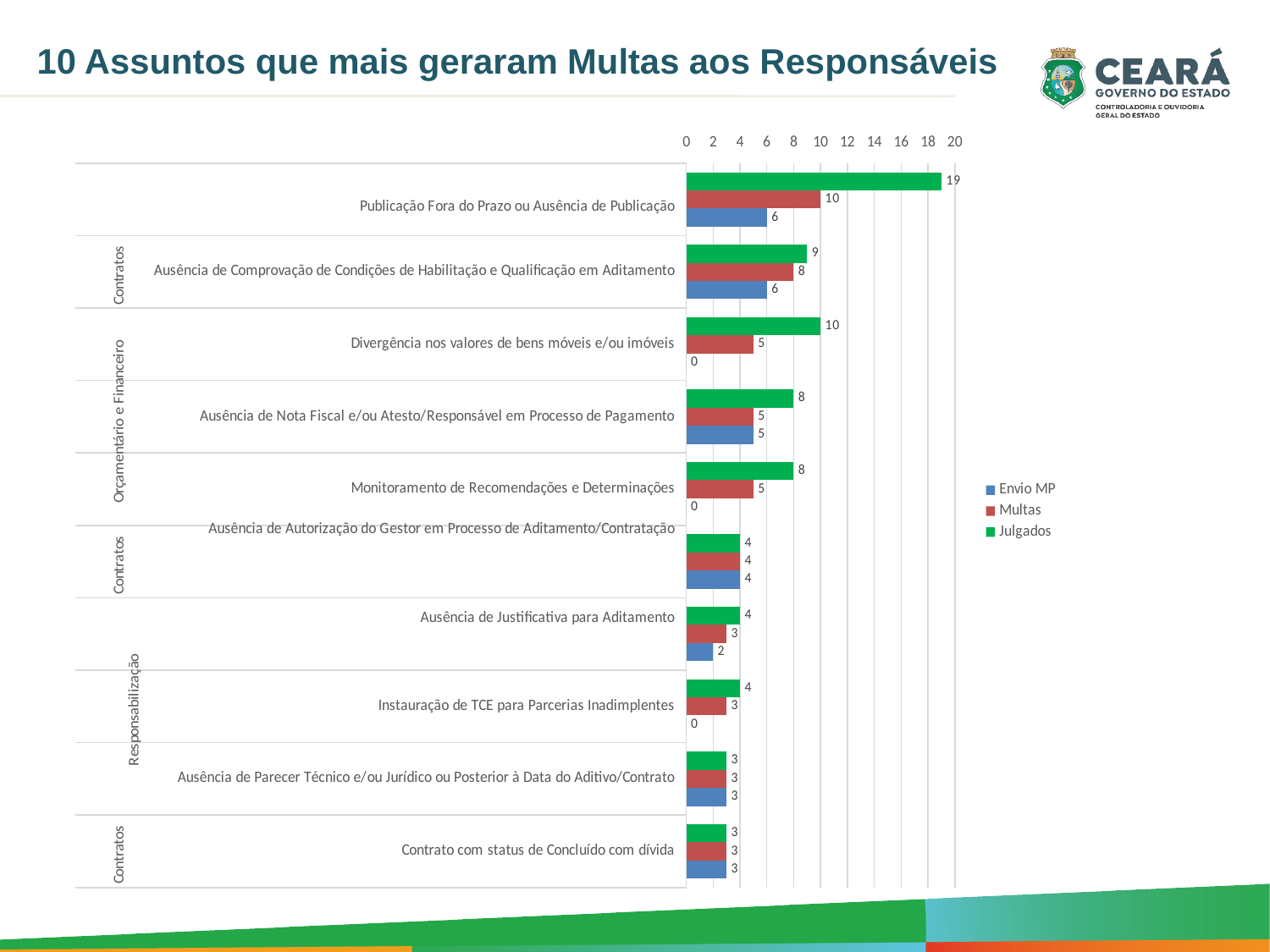
How many subject categories are plotted in the chart? 10 What kind of chart is shown on the slide? Bar chart What is the Julgados value for "Publicação Fora do Prazo ou Ausência de Publicação"? 19 What is the Julgados value for "Contrato com status de Concluído com dívida"? 3 What is the Envio MP value for "Divergência nos valores de bens móveis e/ou imóveis"? 0 Which category has the highest Julgados value? Publicação Fora do Prazo ou Ausência de Publicação How many series does the legend list? 3 What is the difference between the Julgados and Multas values for "Publicação Fora do Prazo ou Ausência de Publicação"? 9 What is the Multas value for "Ausência de Comprovação de Condições de Habilitação e Qualificação em Aditamento"? 8 What is the Envio MP value for "Ausência de Justificativa para Aditamento"? 2 Which series is shown in green in the legend? Julgados Which is larger for "Monitoramento de Recomendações e Determinações": the Julgados value or the Multas value? Julgados